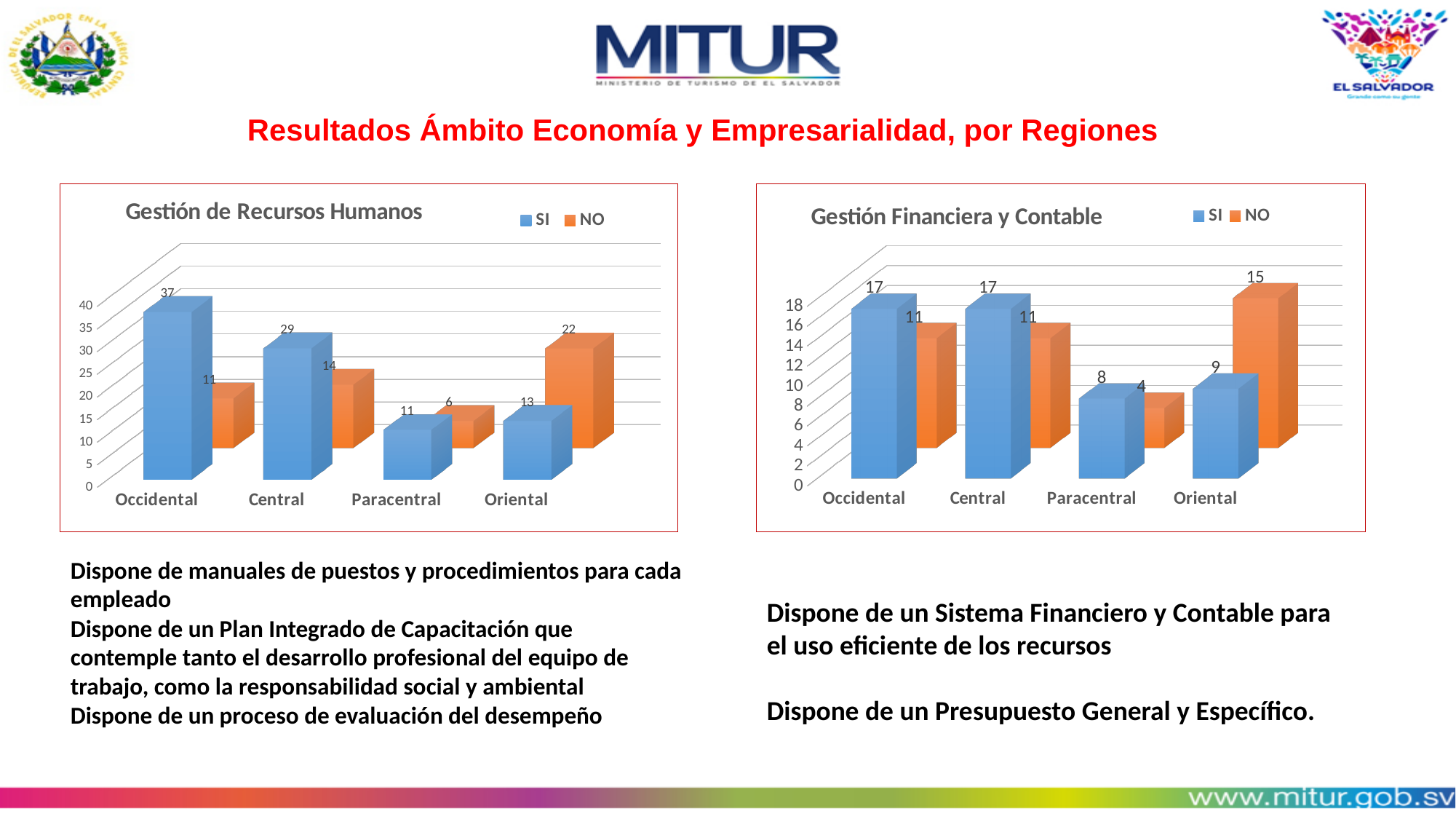
What type of chart is the 'Gestión Financiera y Contable' chart? Bar chart In the 'Gestión Financiera y Contable' chart, what is the NO value for Oriental? 15 In the 'Gestión de Recursos Humanos' chart, what is the SI value for Occidental? 37 In the 'Gestión de Recursos Humanos' chart, which region has the highest SI value? Occidental In the 'Gestión de Recursos Humanos' chart, how many regions are shown on the x axis? 4 In the 'Gestión Financiera y Contable' chart, which region has the lowest NO value? Paracentral In the 'Gestión Financiera y Contable' chart, what is the SI value for Paracentral? 8 In the 'Gestión Financiera y Contable' chart, is the SI value or the NO value larger for Oriental? NO In the 'Gestión de Recursos Humanos' chart, which region has the lowest NO value? Paracentral In the 'Gestión Financiera y Contable' chart, how many series does the legend list? 2 In the 'Gestión de Recursos Humanos' chart, what is the difference between the SI and NO values for Central? 15 In the 'Gestión de Recursos Humanos' chart, what is the NO value for Oriental? 22